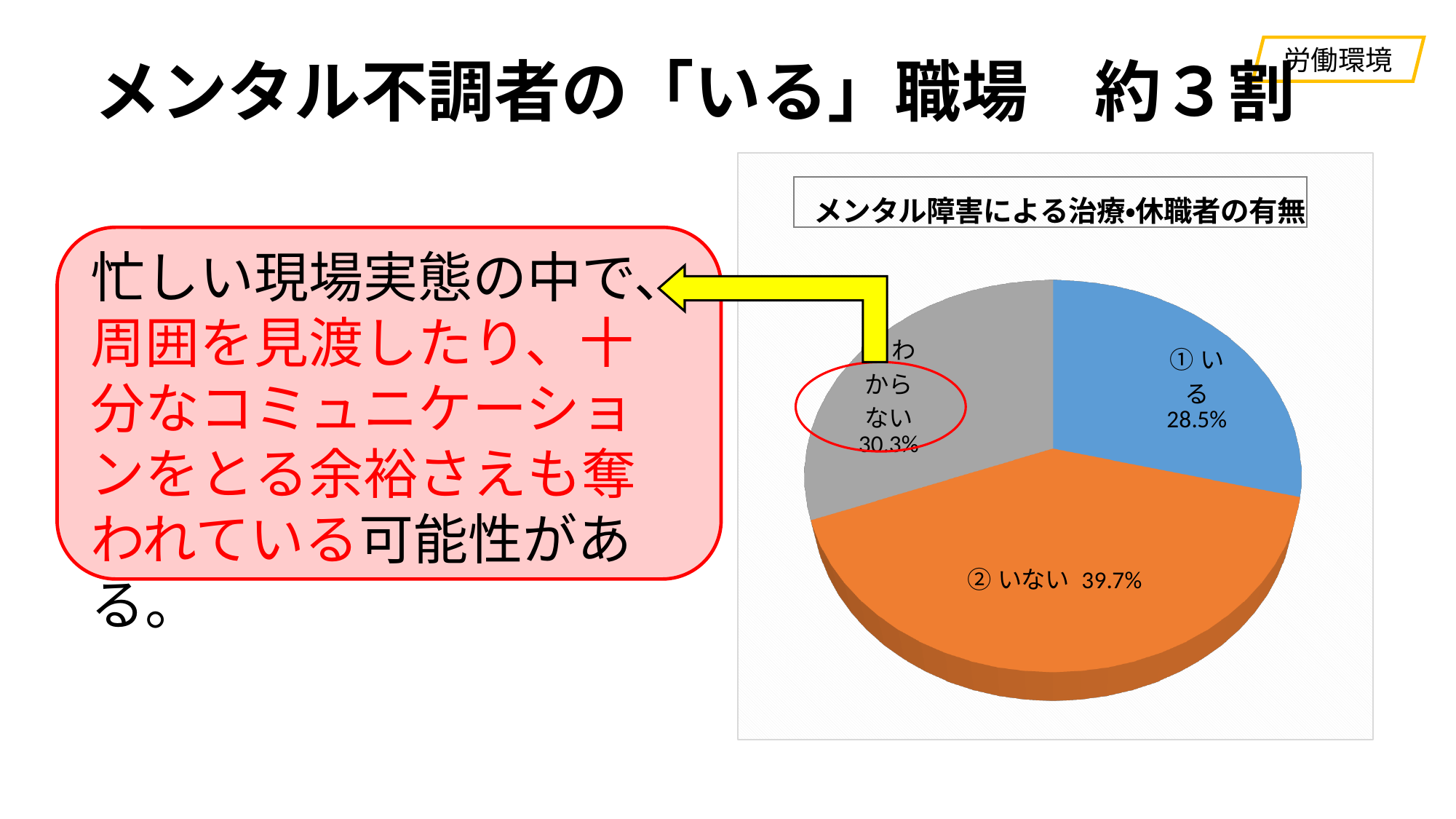
How many slices does the pie chart have? 3 What colour is the slice for ② いない? orange Which is larger, the share for ① いる or the share for わからない? わからない What percentage is shown for わからない? 30.3% What is the title of the chart? メンタル障害による治療•休職者の有無 What percentage is shown for ① いる? 28.5% Which category has the smallest share of the pie? ① いる What is the difference in percentage points between ② いない and わからない? 9.4 Which category has the largest share of the pie? ② いない What percentage is shown for ② いない? 39.7% What is the difference in percentage points between ② いない and ① いる? 11.2 What kind of chart is shown on the slide? pie chart